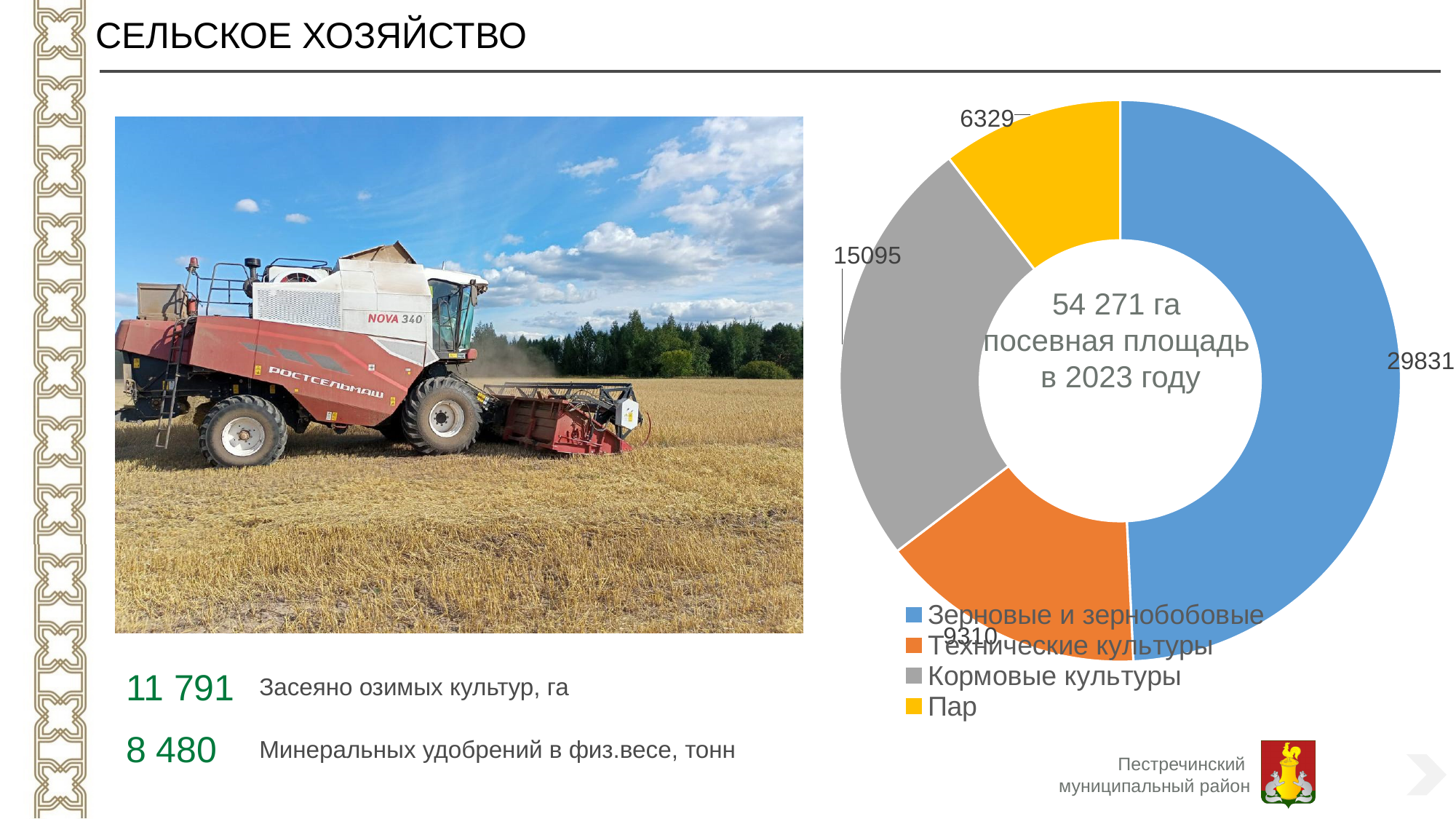
Which category has the smallest slice in the donut chart? Пар Which category has the largest slice in the donut chart? Зерновые и зернобобовые What is the difference between the values for Зерновые и зернобобовые and Кормовые культуры? 14736 What is the value for Пар in the donut chart? 6329 Which is larger: the value for Технические культуры or the value for Пар? Технические культуры What is the difference between the values for Кормовые культуры and Технические культуры? 5785 What is the value for Технические культуры in the donut chart? 9310 What is the value for Кормовые культуры in the donut chart? 15095 How many categories does the donut chart show? 4 What text is shown in the centre of the donut chart? 54 271 га посевная площадь в 2023 году What type of chart is shown on the slide? Donut (pie) chart What is the value for Зерновые и зернобобовые in the donut chart? 29831